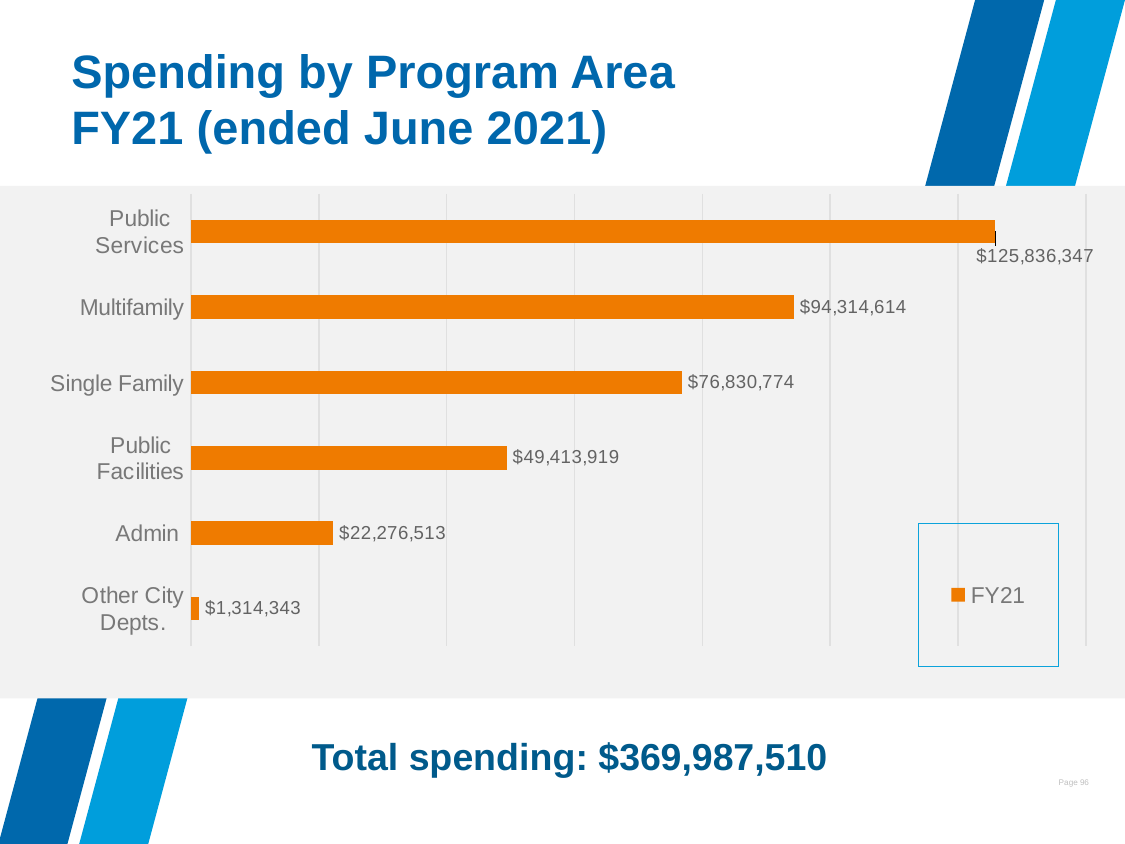
Which has higher spending, Admin or Public Facilities? Public Facilities Which program area has the lowest spending? Other City Depts. Which program area has the highest spending? Public Services How many series does the legend list? 1 What is the FY21 spending for Multifamily? $94,314,614 What is the FY21 spending for Public Services? $125,836,347 What is the FY21 spending for Public Facilities? $49,413,919 What kind of chart is shown on the slide? Bar chart How many program areas are shown in the chart? 6 What is the FY21 spending for Other City Depts.? $1,314,343 What is the difference in spending between Public Services and Multifamily? $31,521,733 What is the difference in spending between Multifamily and Single Family? $17,483,840